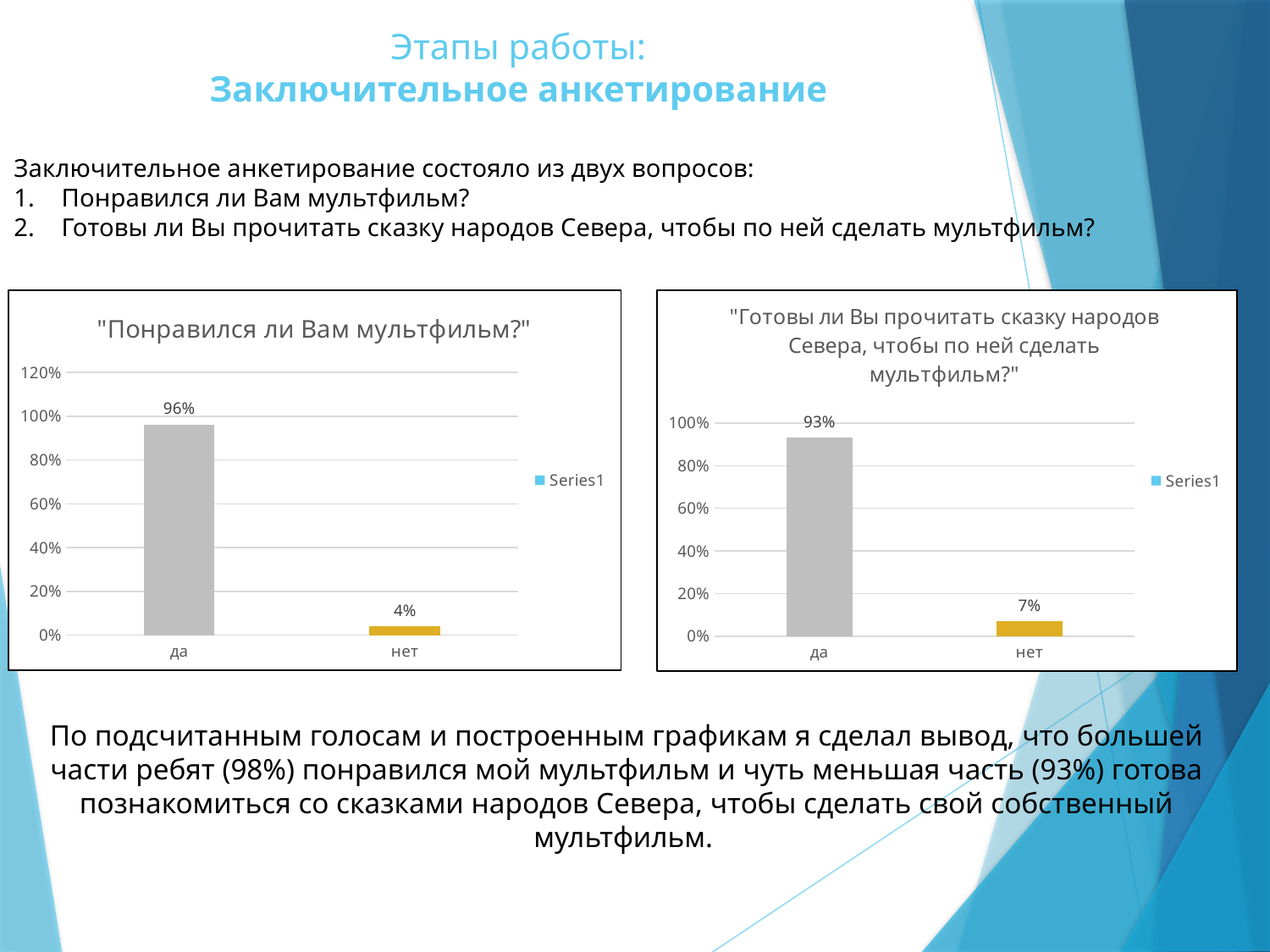
In the right chart "Готовы ли Вы прочитать сказку народов Севера...", what is the value for "нет"? 7% How many series does the legend of the left chart "Понравился ли Вам мультфильм?" list? 1 What type of chart is the right chart "Готовы ли Вы прочитать сказку народов Севера..."? Bar chart Which is larger: the value for "да" in the left chart or the value for "да" in the right chart? The left chart (96%) In the right chart "Готовы ли Вы прочитать сказку народов Севера...", what is the difference between the values for "да" and "нет"? 86% In the left chart "Понравился ли Вам мультфильм?", what is the value for "нет"? 4% In the right chart "Готовы ли Вы прочитать сказку народов Севера...", which category has the lowest value? нет In the left chart "Понравился ли Вам мультфильм?", what is the value for "да"? 96% In the left chart "Понравился ли Вам мультфильм?", which category has the highest value? да In the right chart "Готовы ли Вы прочитать сказку народов Севера...", what is the value for "да"? 93% In the left chart "Понравился ли Вам мультфильм?", what is the difference between the values for "да" and "нет"? 92% How many categories are shown on the x axis of the left chart "Понравился ли Вам мультфильм?"? 2